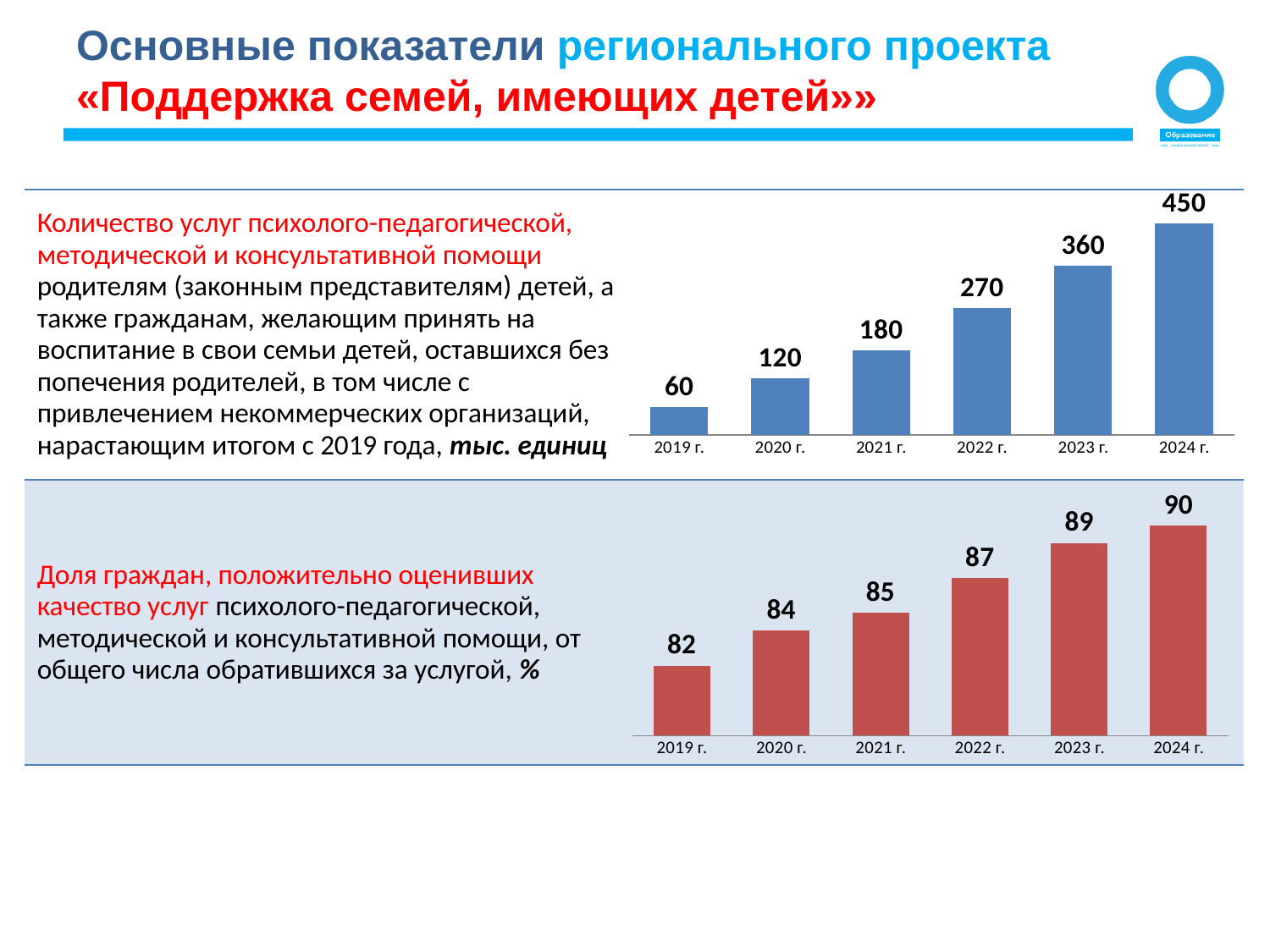
In the top chart (number of services, thousand units), which year has the highest value? 2024 г. In the bottom chart (share of citizens positively rating service quality, %), what is the value for 2024 г.? 90 In the top chart (number of services, thousand units), what is the value for 2019 г.? 60 What type of chart is the bottom chart (share of citizens positively rating service quality, %)? bar chart In the bottom chart (share of citizens positively rating service quality, %), what is the value for 2021 г.? 85 In the top chart (number of services, thousand units), what is the difference between the values for 2024 г. and 2023 г.? 90 In the top chart (number of services, thousand units), what is the value for 2022 г.? 270 In the bottom chart (share of citizens positively rating service quality, %), which year has the lowest value? 2019 г. In the bottom chart (share of citizens positively rating service quality, %), what is the difference between the values for 2024 г. and 2019 г.? 8 In the top chart (number of services, thousand units), how many years are shown on the x axis? 6 In the top chart (number of services, thousand units), do the values rise or fall from 2019 г. to 2024 г.? rise In the bottom chart (share of citizens positively rating service quality, %), which is larger: the value for 2022 г. or 2020 г.? 2022 г.